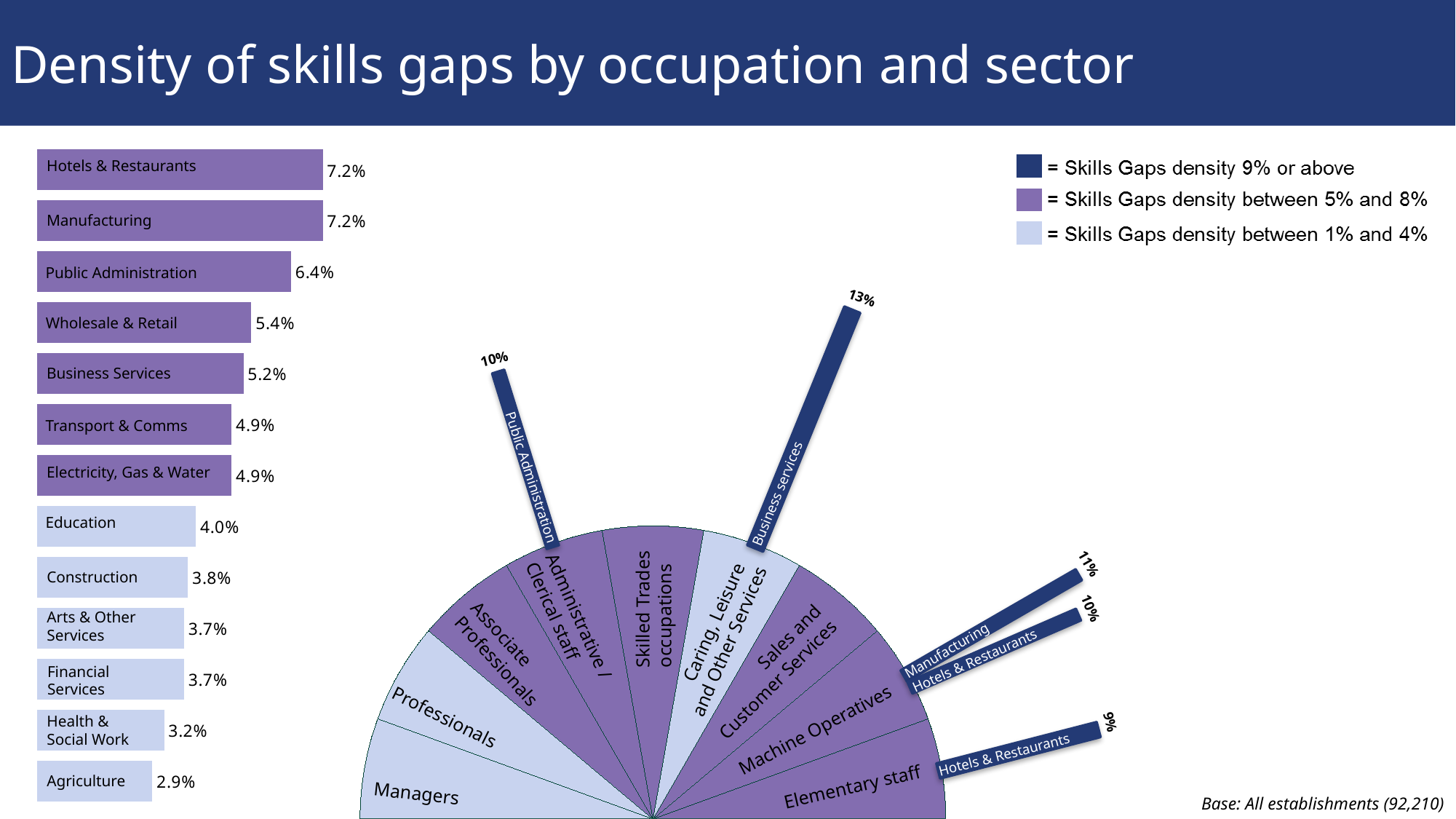
In the bar chart on the left, which is larger, the value for Education or the value for Construction? Education In the bar chart on the left, what is the value for Agriculture? 2.9% In the bar chart on the left, what is the skills gap density for Public Administration? 6.4% How many occupation segments are shown in the semicircle chart on the right? 9 In the semicircle chart on the right, what percentage is shown on the Hotels & Restaurants spike next to Elementary staff? 9% In the bar chart on the left, which sector has the lowest skills gap density? Agriculture How many sectors are shown in the bar chart on the left? 13 In the bar chart on the left, what is the value for Electricity, Gas & Water? 4.9% In the semicircle chart on the right, what percentage is shown on the Business services spike? 13% How many entries does the legend at the top right list? 3 What kind of chart is the chart on the left of the slide? Bar chart In the bar chart on the left, what is the difference between Public Administration and Wholesale & Retail? 1.0%